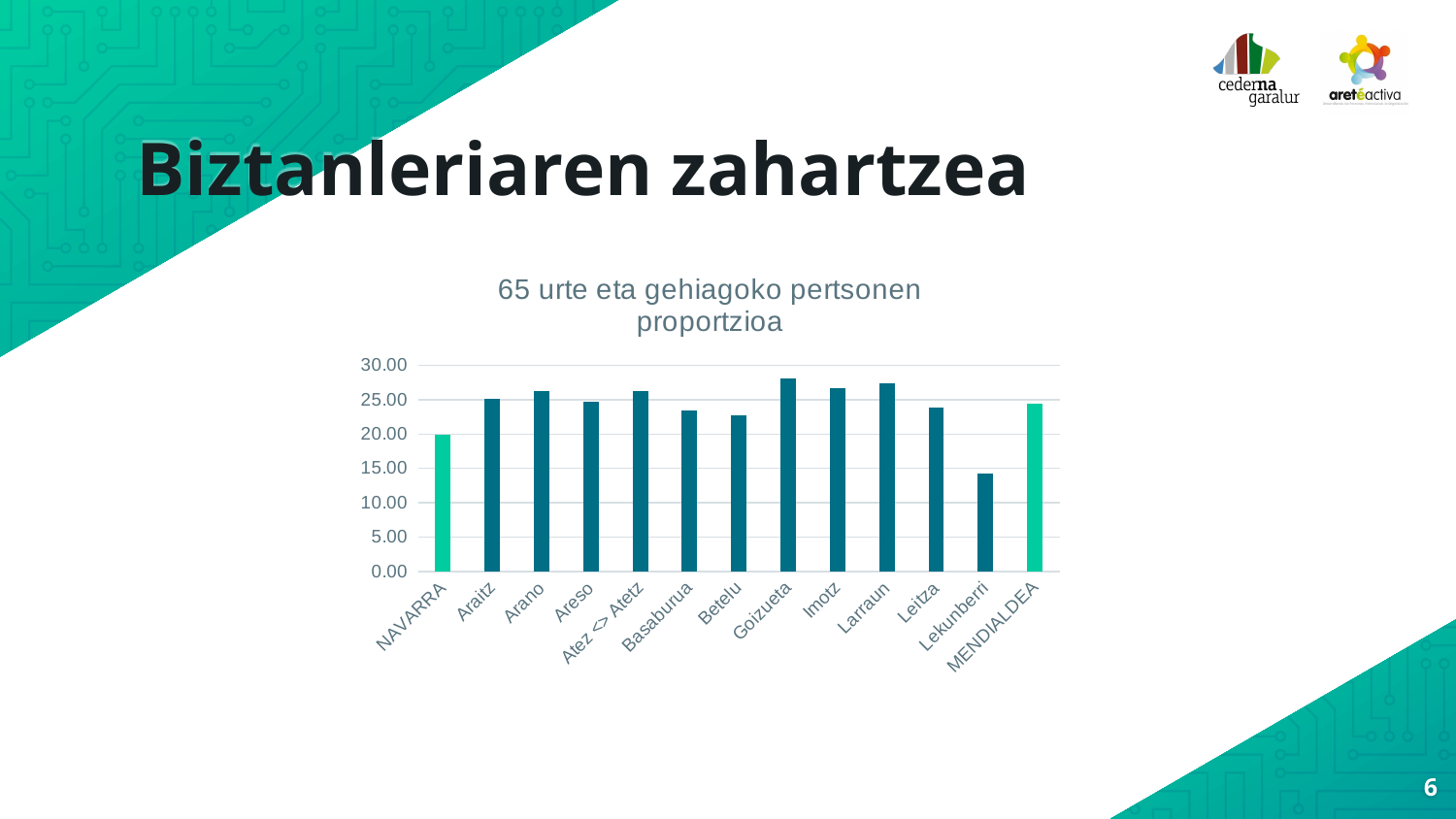
Which is larger, the value for Larraun or the value for Betelu? Larraun Is the value for Lekunberri greater or less than 15.00? less How many categories are shown on the x axis of the chart? 13 What is the title of the chart? 65 urte eta gehiagoko pertsonen proportzioa Which category has the highest bar in the chart? Goizueta Which two categories are drawn in a lighter green colour than the other bars? NAVARRA and MENDIALDEA Which is larger, the value for NAVARRA or the value for Arano? Arano Is the value for Goizueta greater or less than 25.00? greater Is the value for Basaburua greater or less than 25.00? less What kind of chart is shown on the slide? bar chart Which category has the lowest bar in the chart? Lekunberri